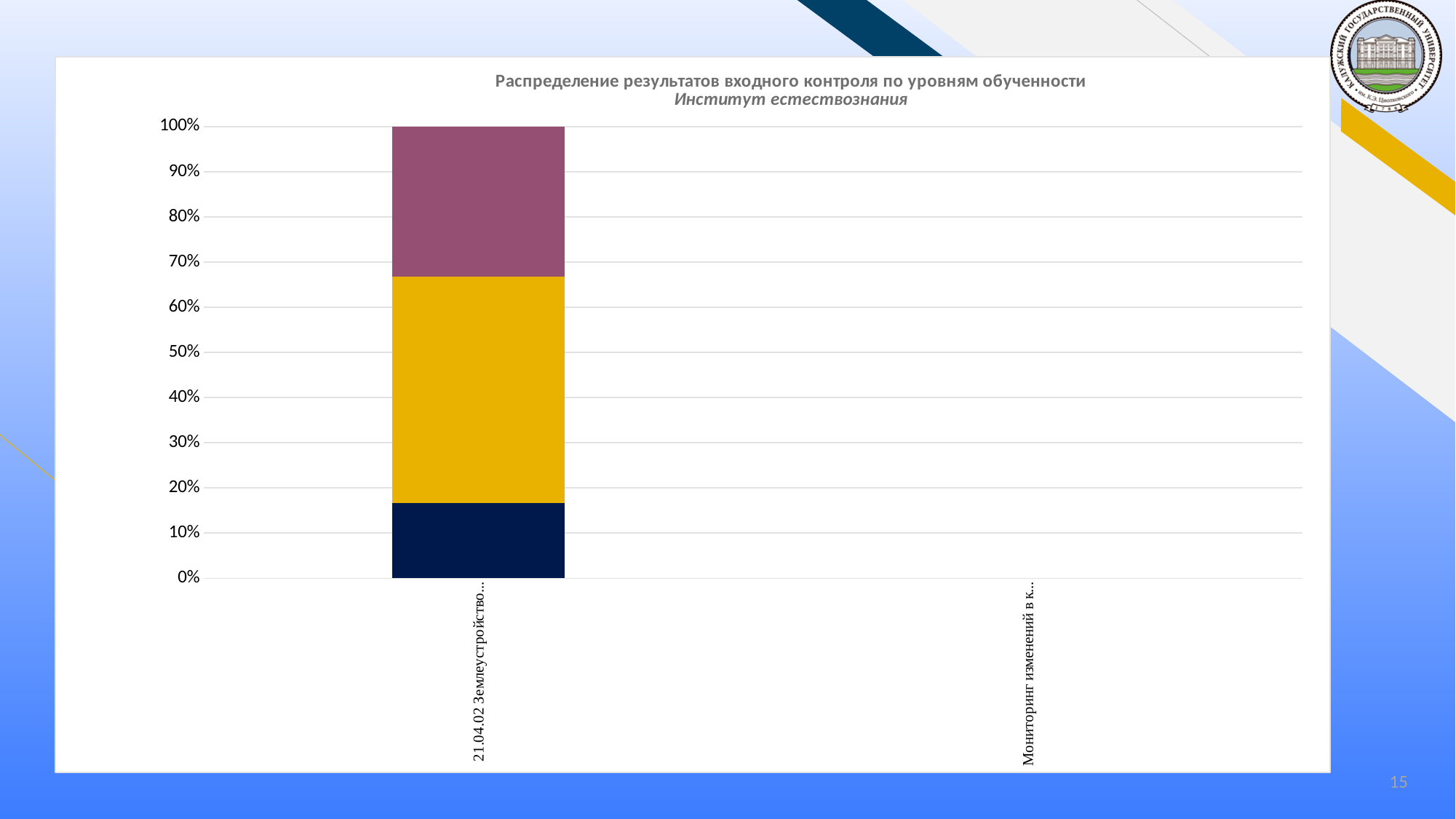
What kind of chart is shown on the slide? Stacked bar chart What is the title of the chart? Распределение результатов входного контроля по уровням обученности Is the top of the dark blue segment of the bar for 21.04.02 Землеустройство... greater or less than 10%? greater Which coloured segment is the smallest in the bar for 21.04.02 Землеустройство...? Dark blue Which institute is named in the chart's subtitle? Институт естествознания Is the top of the yellow segment of the bar for 21.04.02 Землеустройство... greater or less than 60%? greater Is the top of the yellow segment of the bar for 21.04.02 Землеустройство... greater or less than 70%? less What value does the top of the stacked bar for 21.04.02 Землеустройство... reach on the y axis? 100% How many category labels are shown on the x axis? 2 Is the yellow segment or the purple segment larger in the bar for 21.04.02 Землеустройство...? Yellow Which coloured segment is the largest in the bar for 21.04.02 Землеустройство...? Yellow